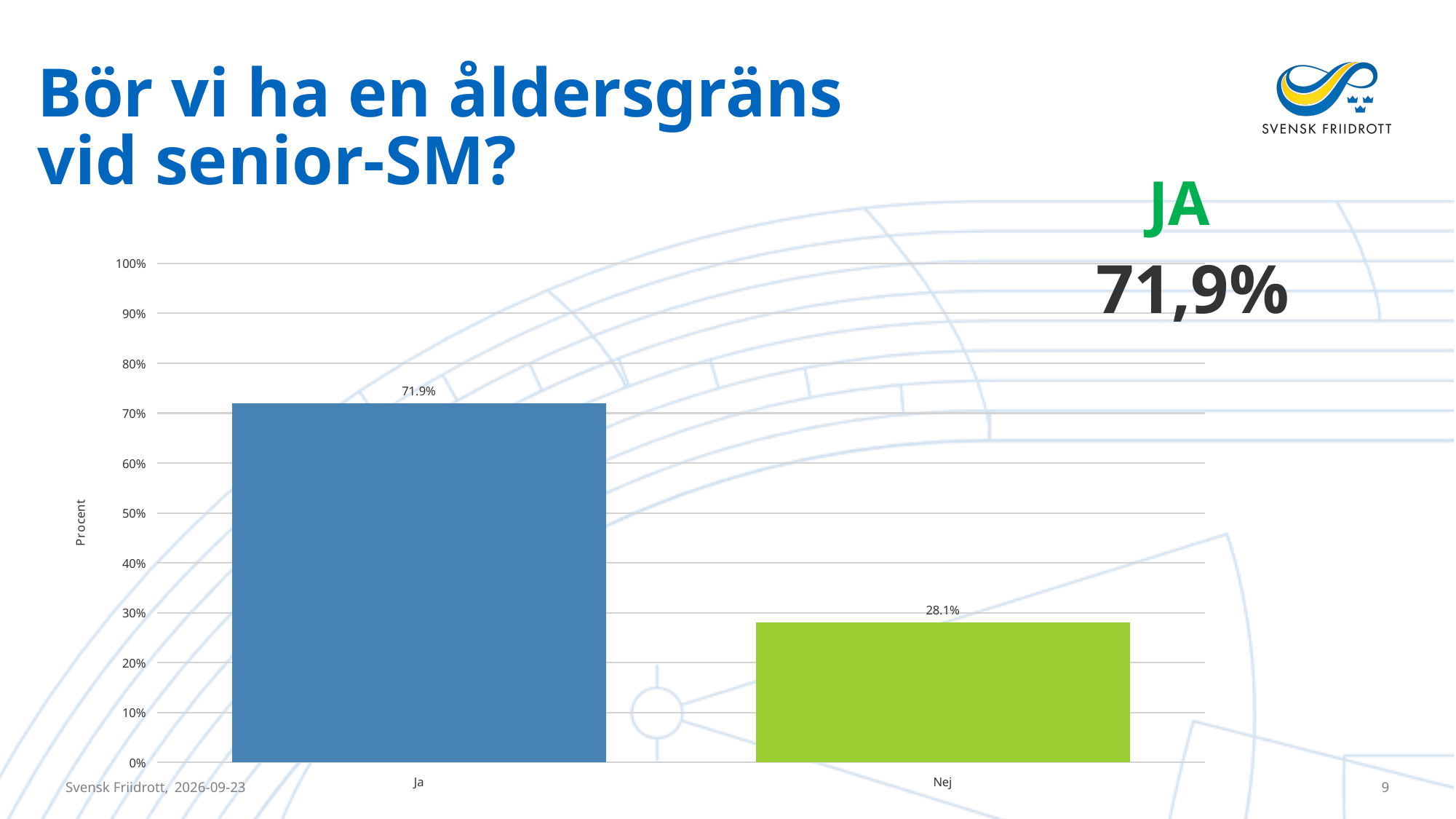
Which is larger, the value for Ja or the value for Nej? Ja Is the value for Nej greater or less than 30%? less What colour is the bar for Nej? green What is the label of the y axis? Procent Which category has the highest value? Ja What is the value for Ja? 71.9% What is the difference between the values for Ja and Nej? 43.8% What kind of chart is shown on the slide? bar chart Is the value for Ja greater or less than 70%? greater Which category has the lowest value? Nej What is the value for Nej? 28.1% How many categories are shown on the x axis? 2